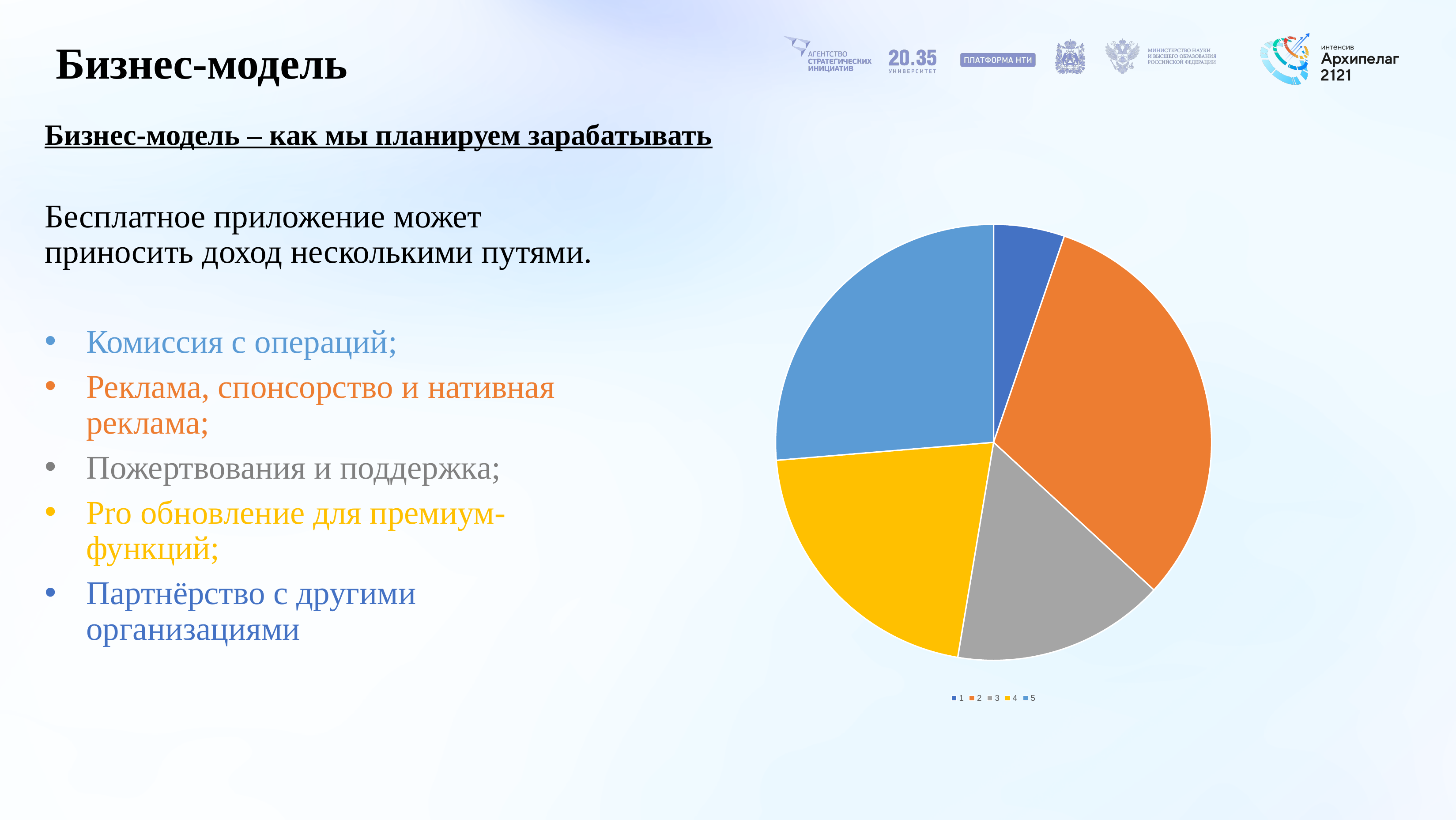
Which legend category has the largest slice in the pie chart? 2 Which legend category has the smallest slice in the pie chart? 1 Which slice is larger in the pie chart, category 4 or category 3? 4 What kind of chart is shown on the slide? pie chart How many entries does the legend of the pie chart list? 5 Which slice is larger in the pie chart, category 2 or category 1? 2 Which slice is larger in the pie chart, category 5 or category 1? 5 What are the legend entries of the pie chart? 1, 2, 3, 4, 5 What colour is the slice for category 2 in the pie chart? orange How many slices does the pie chart have? 5